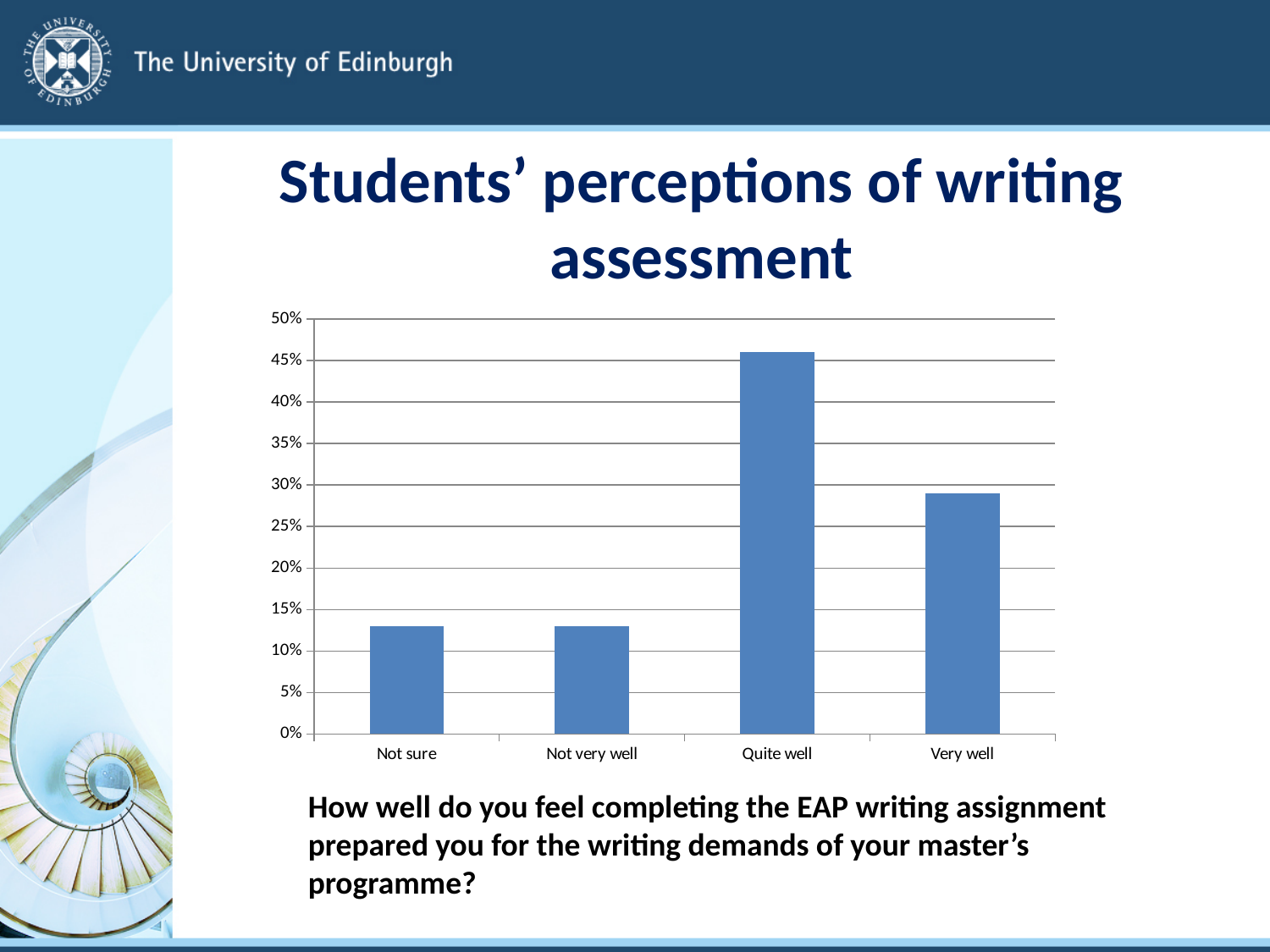
Which is larger, the value for Very well or the value for Not sure? Very well Is the value for Not very well greater or less than 15%? less Is the value for Not sure greater or less than 10%? greater What is the title of the slide containing the chart? Students' perceptions of writing assessment Is the value for Quite well greater or less than 50%? less Which category has the highest value in the chart? Quite well How many categories are shown on the x axis of the chart? 4 Which is larger, the value for Quite well or the value for Very well? Quite well What is the highest value shown on the y axis of the chart? 50% What kind of chart is shown on the slide? bar chart